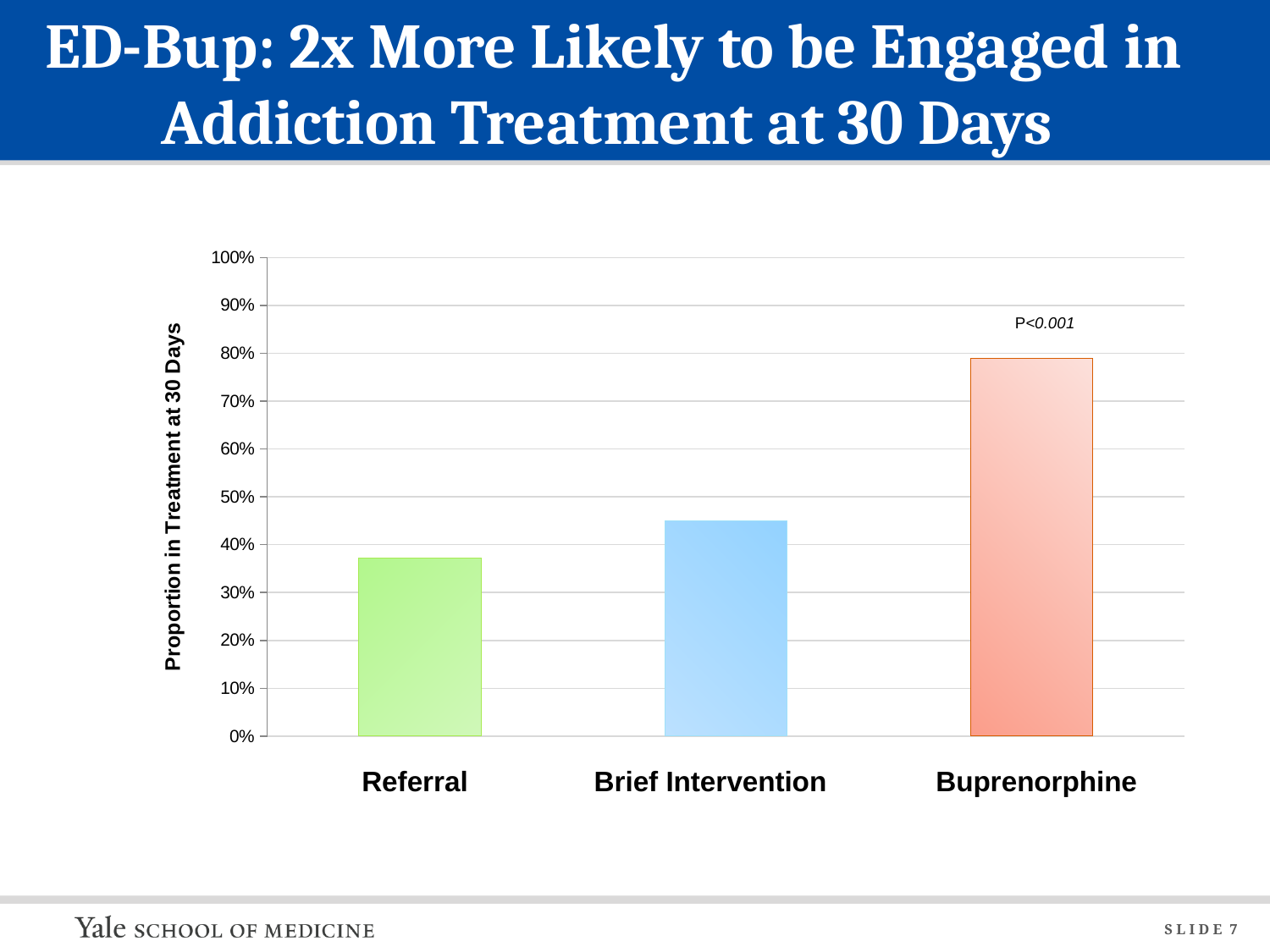
What kind of chart is shown on the slide? Bar chart Is the value for Referral greater or less than 40%? less Is the value for Brief Intervention greater or less than 40%? greater Is the value for Brief Intervention greater or less than 50%? less Which is larger, the value for Brief Intervention or the value for Buprenorphine? Buprenorphine Which category has the lowest proportion in treatment at 30 days? Referral Do the bar values rise or fall from left to right across the categories? Rise How many categories are plotted on the chart? 3 What p-value annotation is printed above the Buprenorphine bar? P<0.001 Which category has the highest proportion in treatment at 30 days? Buprenorphine What is the label on the vertical axis of the chart? Proportion in Treatment at 30 Days